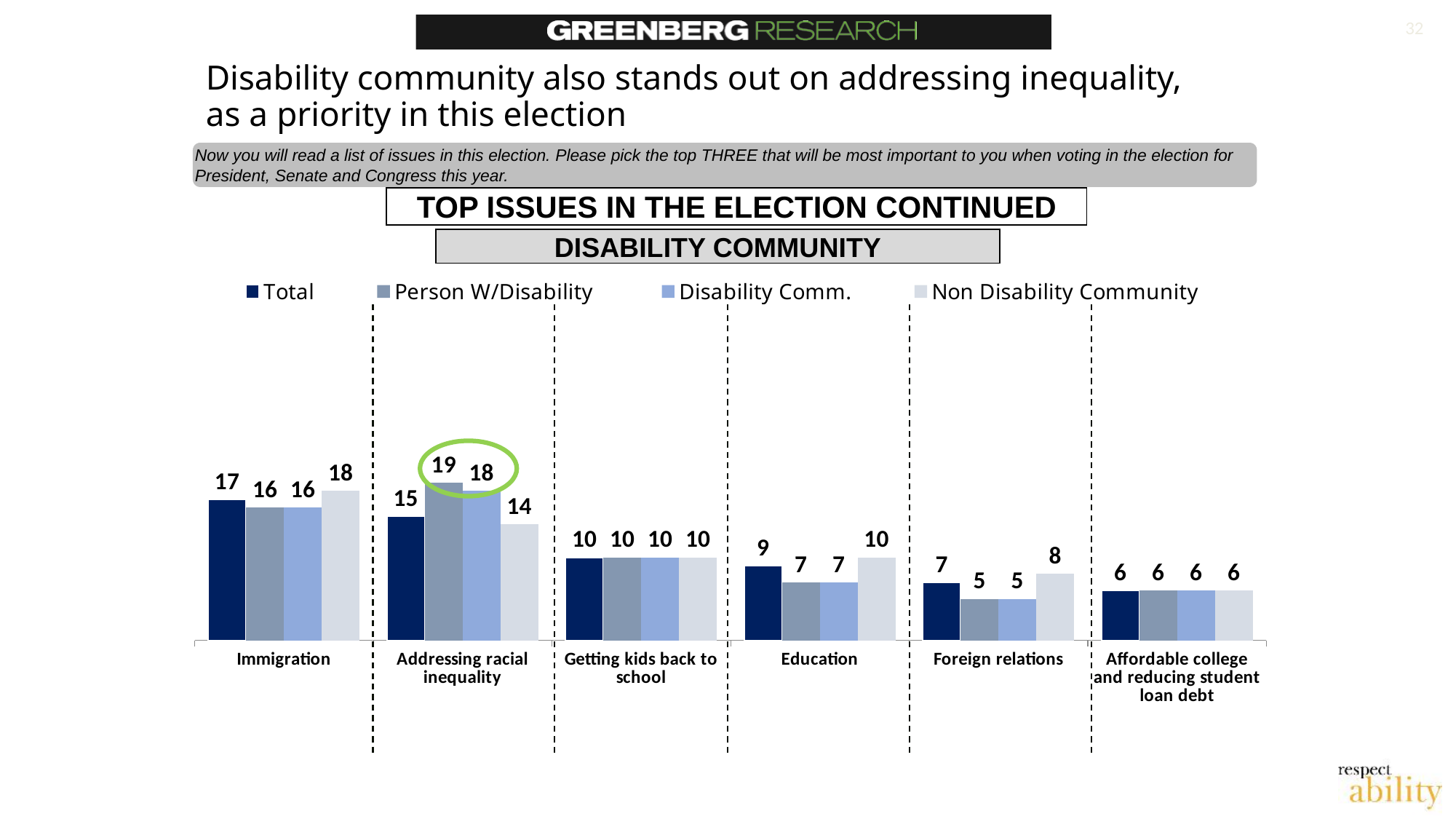
What is the value for Non Disability Community on Immigration? 18 Which category has the lowest value for the Non Disability Community series? Affordable college and reducing student loan debt How many series does the legend list? 4 What is the value for Total on Education? 9 Which category has the highest value for the Total series? Immigration What is the difference between the Person W/Disability and Non Disability Community values on Addressing racial inequality? 5 How many issue categories are shown on the x axis? 6 What is the value for Disability Comm. on Foreign relations? 5 Which data label is circled in green on the chart? 19 and 18 (Person W/Disability and Disability Comm. on Addressing racial inequality) What is the value for Person W/Disability on Addressing racial inequality? 19 What kind of chart is shown on the slide? Bar chart On Foreign relations, which is larger: the Total value or the Non Disability Community value? Non Disability Community